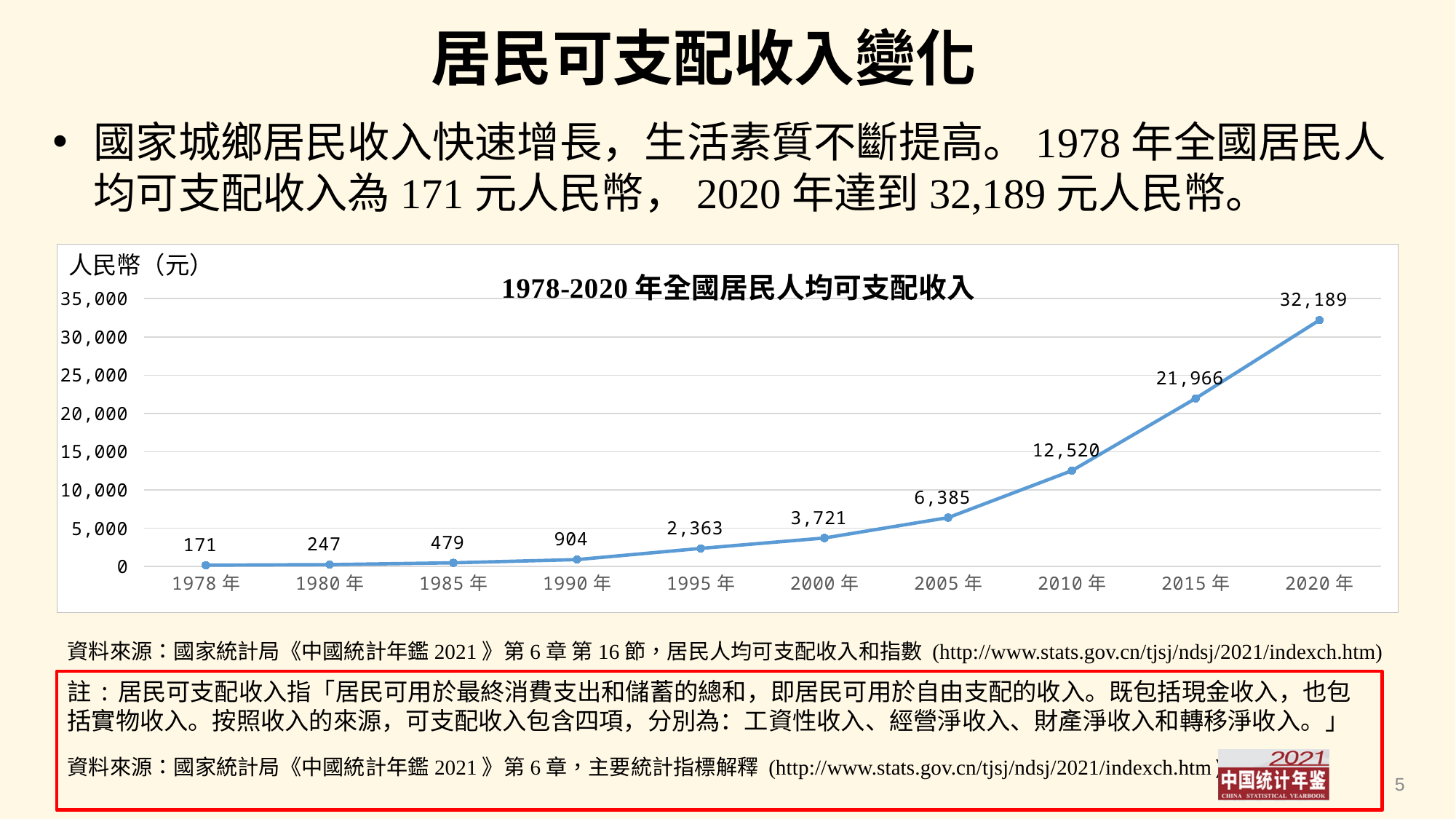
Which year has the highest plotted value? 2020年 What is the per capita disposable income value plotted for 1990年? 904 What is the difference between the values for 2010年 and 2000年? 8,799 What is the value plotted for 2005年? 6,385 What is the title of the chart? 1978-2020年全國居民人均可支配收入 Do the values rise or fall from 1978年 to 2020年? rise What type of chart is shown on the slide? line chart Which is larger, the value for 1995年 or the value for 2000年? 2000年 What is the difference between the values for 2020年 and 2015年? 10,223 How many data points are plotted on the line? 10 Which year has the lowest plotted value? 1978年 What is the value plotted for 2015年? 21,966